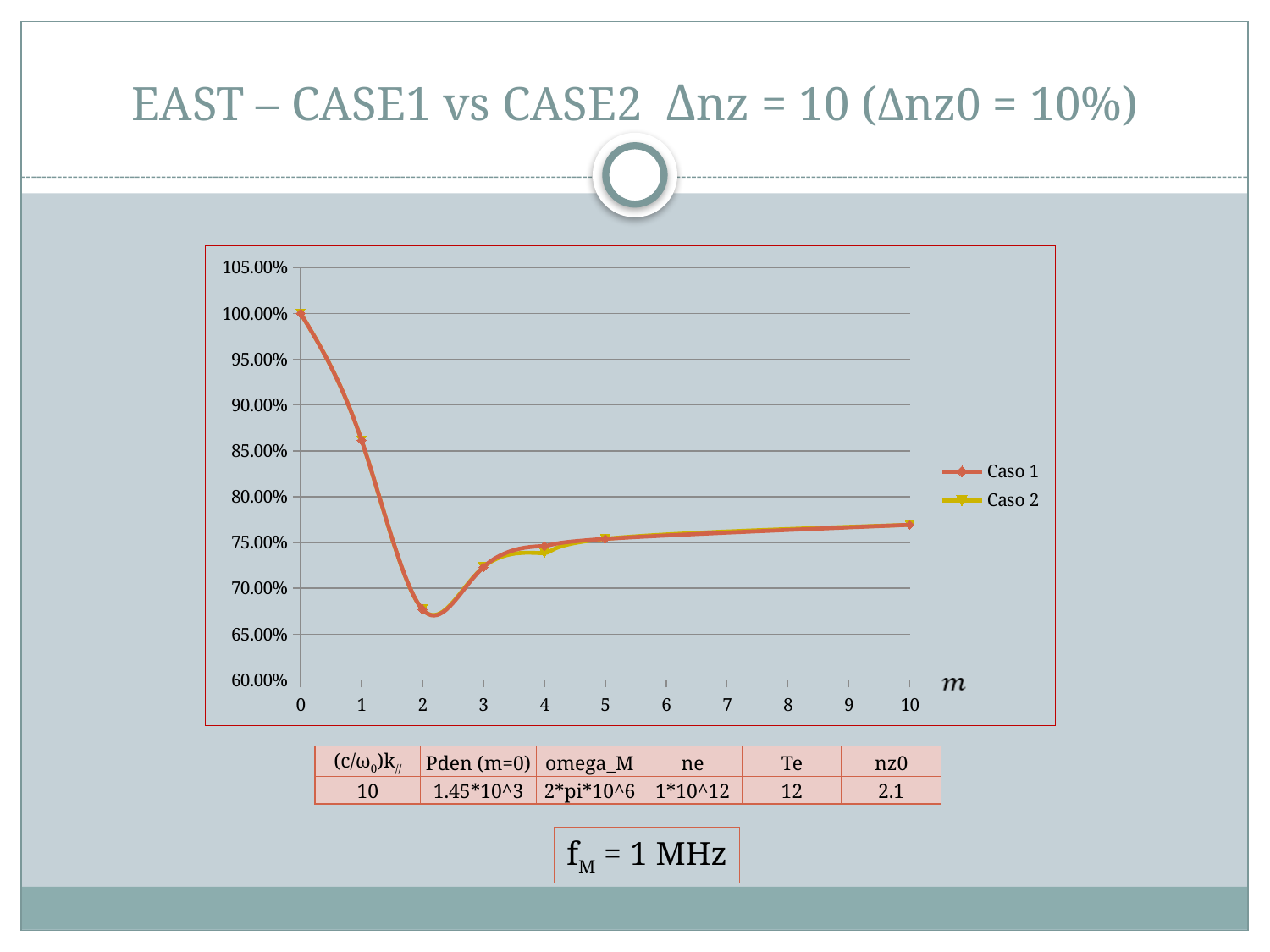
What are the names of the two series in the legend? Caso 1 and Caso 2 How many series does the chart legend list? 2 At which value of m does Caso 1 reach its highest value? 0 At which value of m does Caso 1 reach its lowest value? 2 What is the value of Caso 1 at m = 0? 100.00% Do the values of Caso 2 rise or fall as m goes from 2 to 10? rise Is the value of Caso 1 at m = 10 greater or less than 75.00%? greater What kind of chart is shown on the slide? line chart Is the value of Caso 1 at m = 2 greater or less than 70.00%? less Do the values of Caso 1 rise or fall as m goes from 0 to 2? fall Is the value of Caso 1 at m = 1 greater or less than 90.00%? less What is the label on the x axis of the chart? m